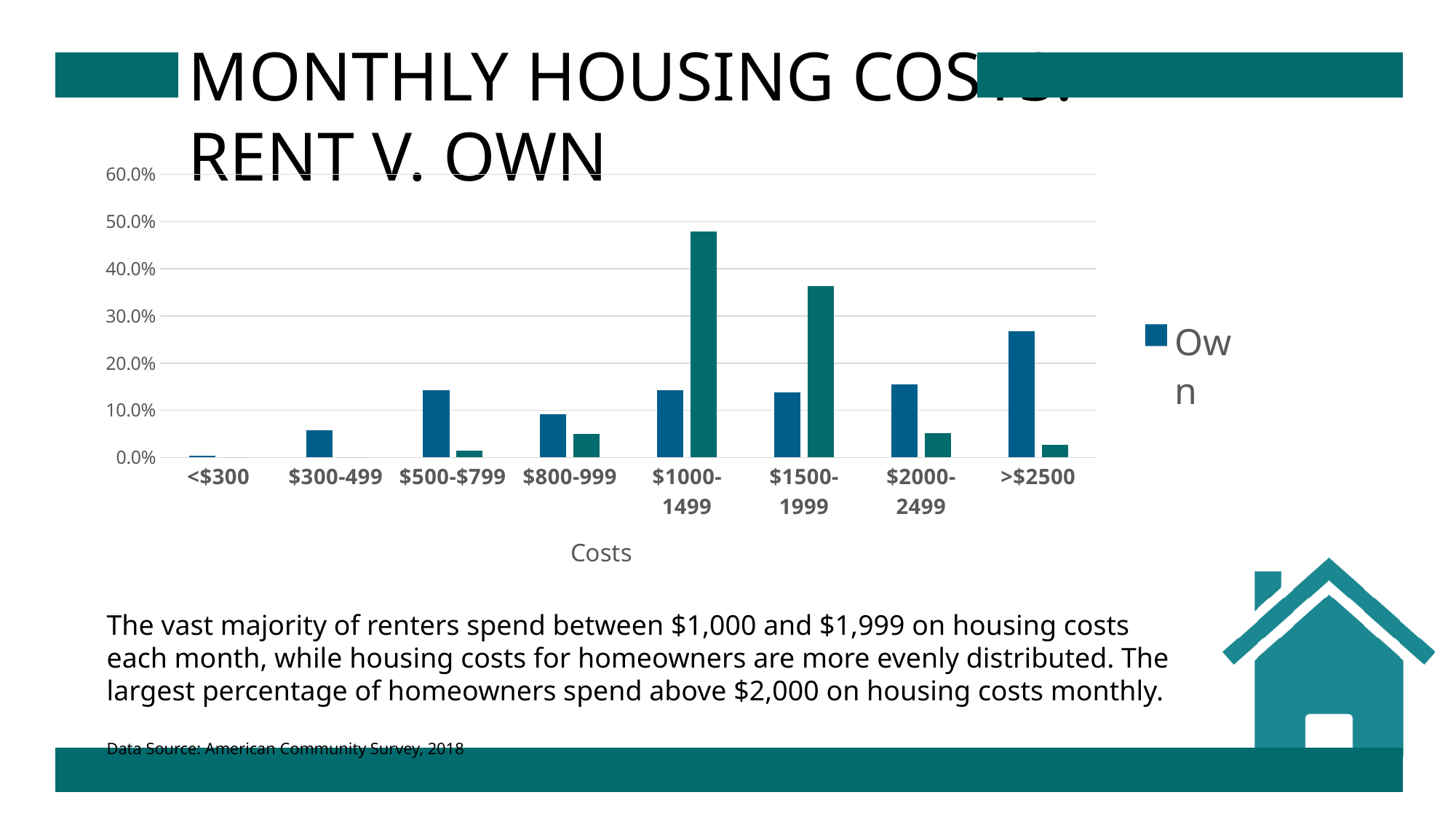
Which series name is readable in the legend? Own How many cost categories are shown on the x axis? 8 What is the title of the x axis? Costs Is the Own value for >$2500 greater or less than 20.0%? greater Which cost category has the lowest value for the Own series? <$300 Is the value of the teal (second) series for $1500-1999 greater or less than 30.0%? greater Is the value of the teal (second) series for $1000-1499 greater or less than 40.0%? greater Which cost category has the tallest bar on the chart? $1000-1499 What kind of chart is shown on the slide? bar chart For the $1000-1499 category, which is larger: the Own bar or the teal (second) bar? the teal (second) bar Which cost category has the highest value for the Own series? >$2500